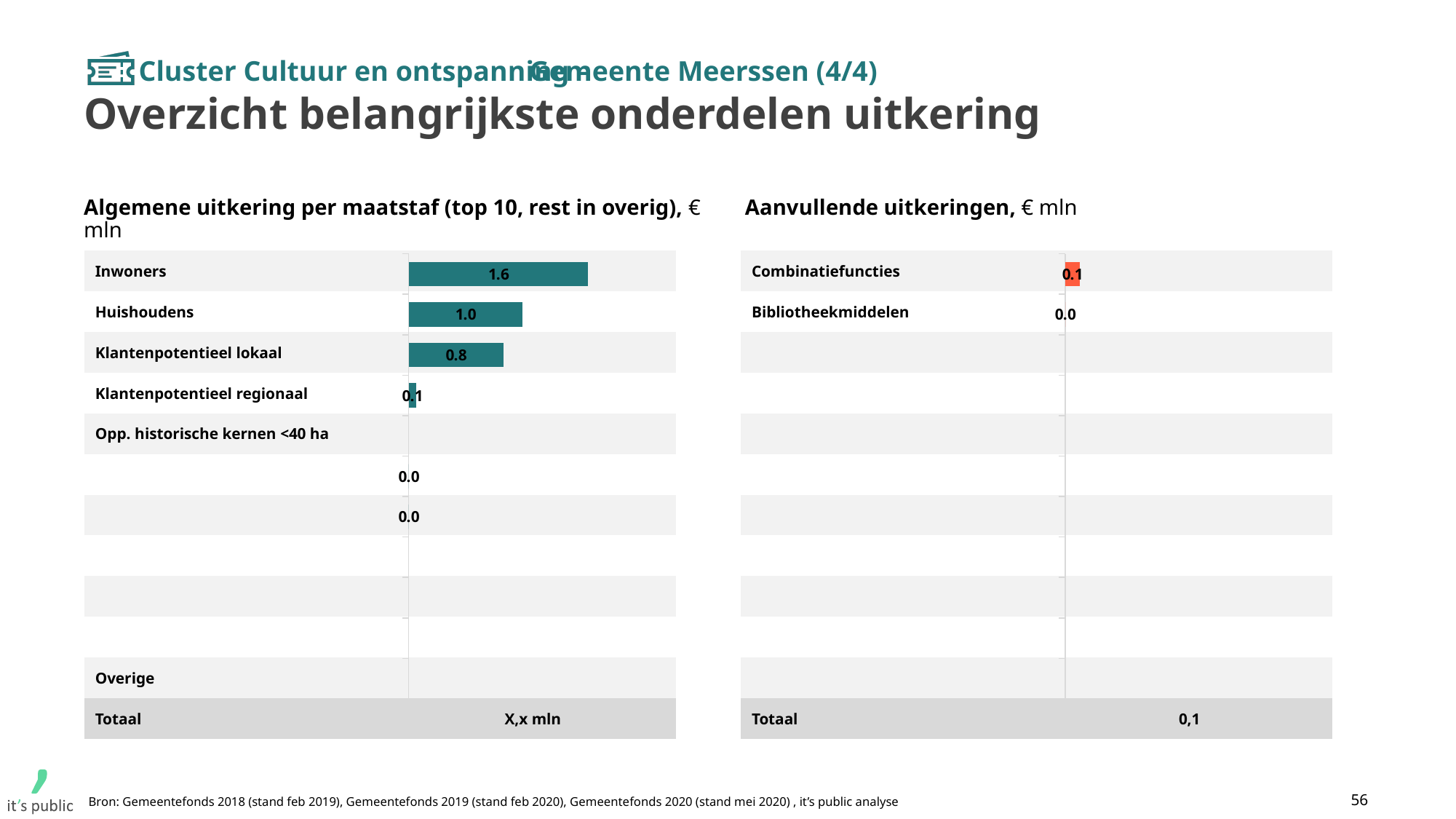
In the chart 'Aanvullende uitkeringen', what is the Totaal shown at the bottom? 0,1 In the chart 'Algemene uitkering per maatstaf', what is the value for Huishoudens? 1.0 In the chart 'Algemene uitkering per maatstaf', what is the value for Klantenpotentieel regionaal? 0.1 In the chart 'Aanvullende uitkeringen', what is the value for Combinatiefuncties? 0.1 What kind of chart is the 'Aanvullende uitkeringen' chart? bar chart In the chart 'Algemene uitkering per maatstaf', what is the value for Inwoners? 1.6 In the chart 'Algemene uitkering per maatstaf', which category has the highest value? Inwoners In the chart 'Algemene uitkering per maatstaf', which is larger: Huishoudens or Klantenpotentieel lokaal? Huishoudens In the chart 'Algemene uitkering per maatstaf', what is the difference between Inwoners and Huishoudens? 0.6 In the chart 'Aanvullende uitkeringen', what is the value for Bibliotheekmiddelen? 0.0 In the chart 'Algemene uitkering per maatstaf', what is the value for Klantenpotentieel lokaal? 0.8 In the chart 'Algemene uitkering per maatstaf', what is the difference between Klantenpotentieel lokaal and Klantenpotentieel regionaal? 0.7